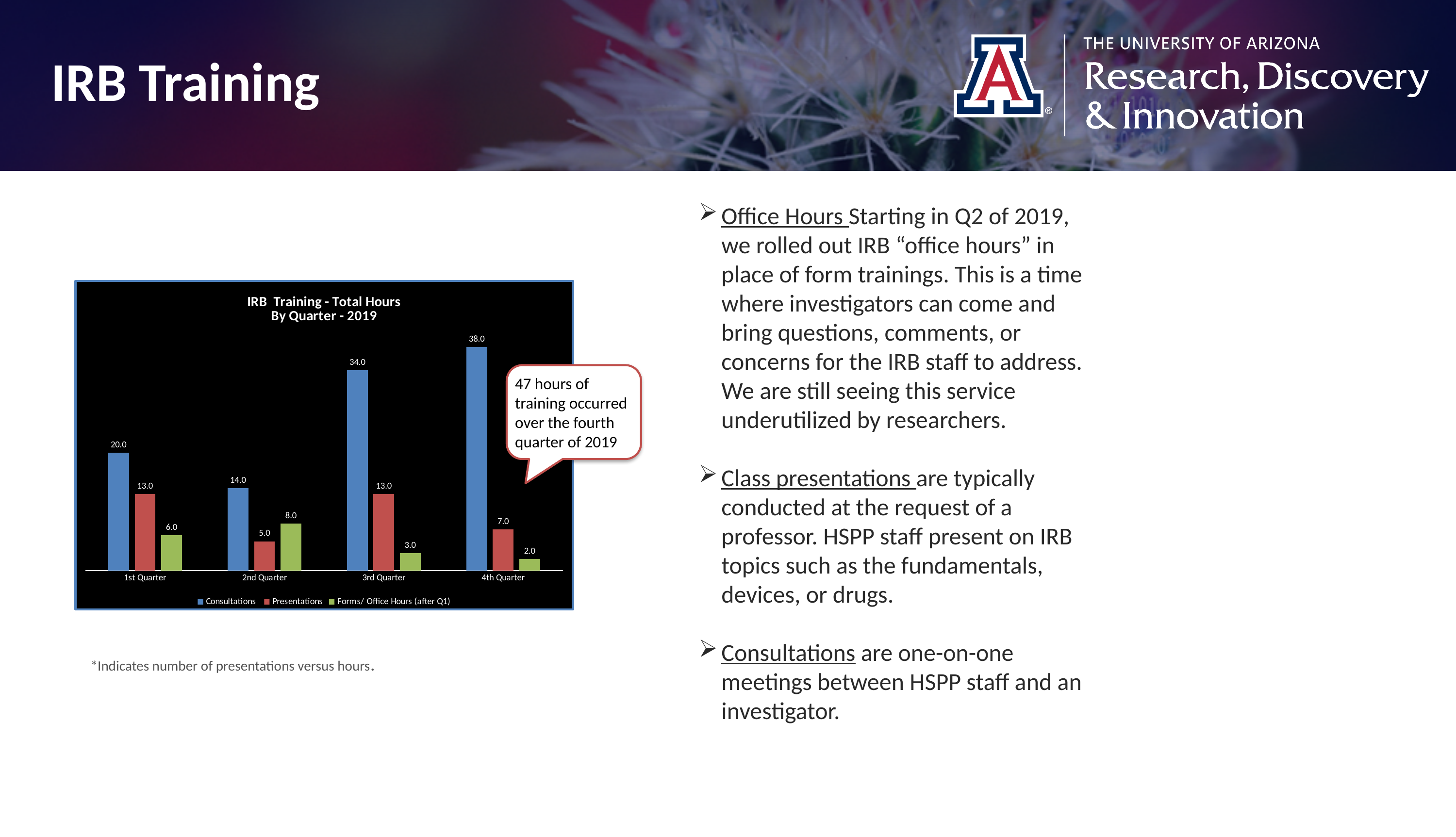
What is the value for Presentations in the 1st Quarter? 13.0 Which is larger: Presentations in the 2nd Quarter or Forms/ Office Hours (after Q1) in the 2nd Quarter? Forms/ Office Hours (after Q1) What is the value for Consultations in the 4th Quarter? 38.0 How many series does the legend list? 3 What is the difference between Consultations in the 3rd Quarter and the 2nd Quarter? 20.0 What kind of chart is shown? Bar chart Do the Presentations values rise or fall from the 3rd Quarter to the 4th Quarter? Fall Which quarter has the highest value for Consultations? 4th Quarter What is the title of the chart? IRB Training - Total Hours By Quarter - 2019 What is the value for Forms/ Office Hours (after Q1) in the 2nd Quarter? 8.0 Which quarter has the lowest value for Forms/ Office Hours (after Q1)? 4th Quarter How many quarters are shown on the x axis? 4